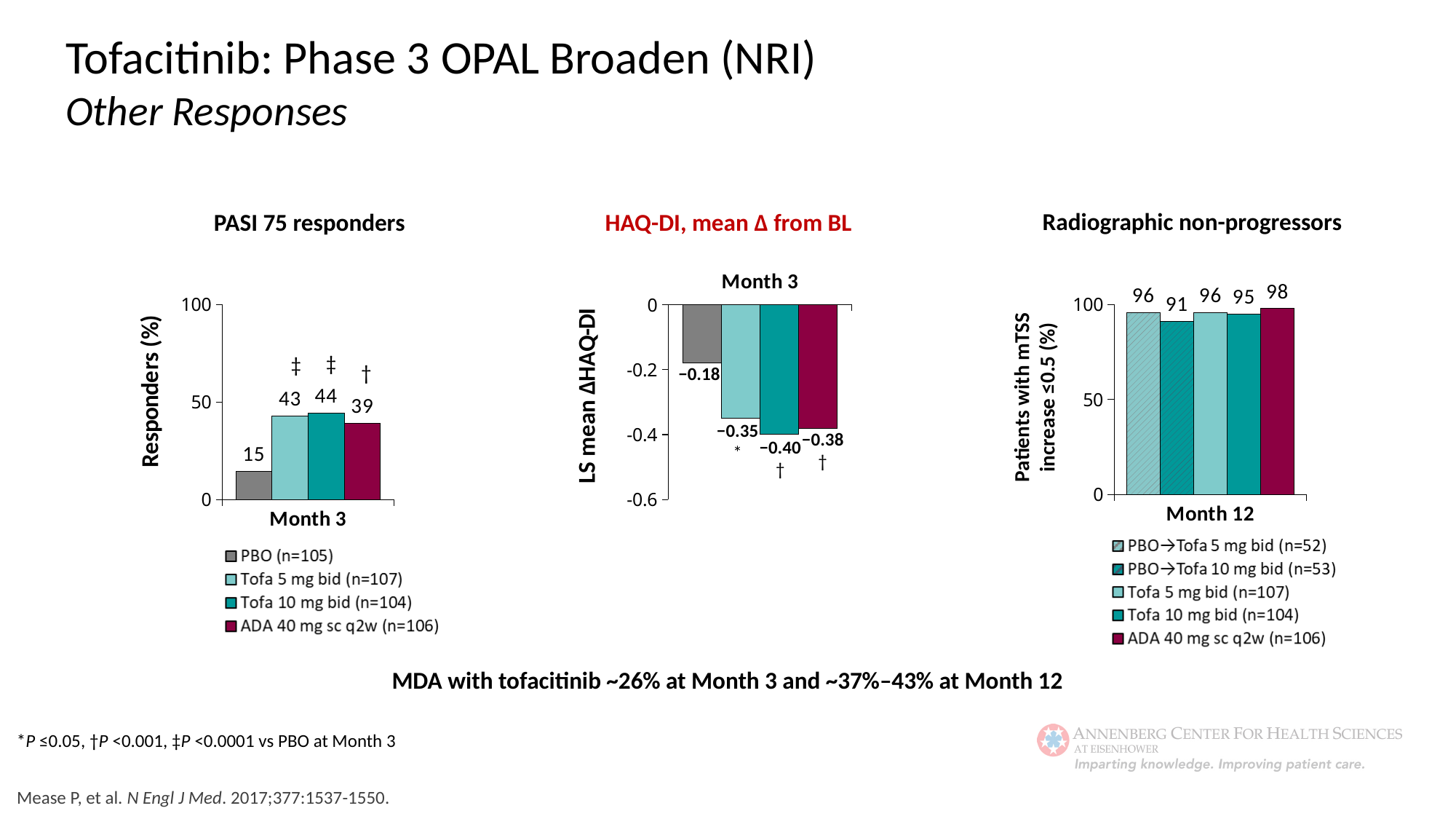
In the HAQ-DI, mean Δ from BL chart, which group has the smallest change from baseline in magnitude? PBO (n=105) In the Radiographic non-progressors chart, what is the difference between ADA 40 mg sc q2w and PBO→Tofa 10 mg bid? 7 In the HAQ-DI, mean Δ from BL chart, what is the value for ADA 40 mg sc q2w? -0.38 In the PASI 75 responders chart, which group has the highest responder percentage? Tofa 10 mg bid (n=104) In the Radiographic non-progressors chart, which group has the highest percentage of patients with mTSS increase ≤0.5? ADA 40 mg sc q2w (n=106) In the PASI 75 responders chart, how many series does the legend list? 4 In the Radiographic non-progressors chart, how many bars are plotted? 5 In the HAQ-DI, mean Δ from BL chart, what is the value for Tofa 10 mg bid? -0.40 In the PASI 75 responders chart, what is the value for PBO (n=105)? 15 In the Radiographic non-progressors chart, what is the value for PBO→Tofa 10 mg bid (n=53)? 91 In the PASI 75 responders chart, what is the difference between Tofa 5 mg bid and PBO? 28 What kind of chart is the HAQ-DI, mean Δ from BL chart? Bar chart